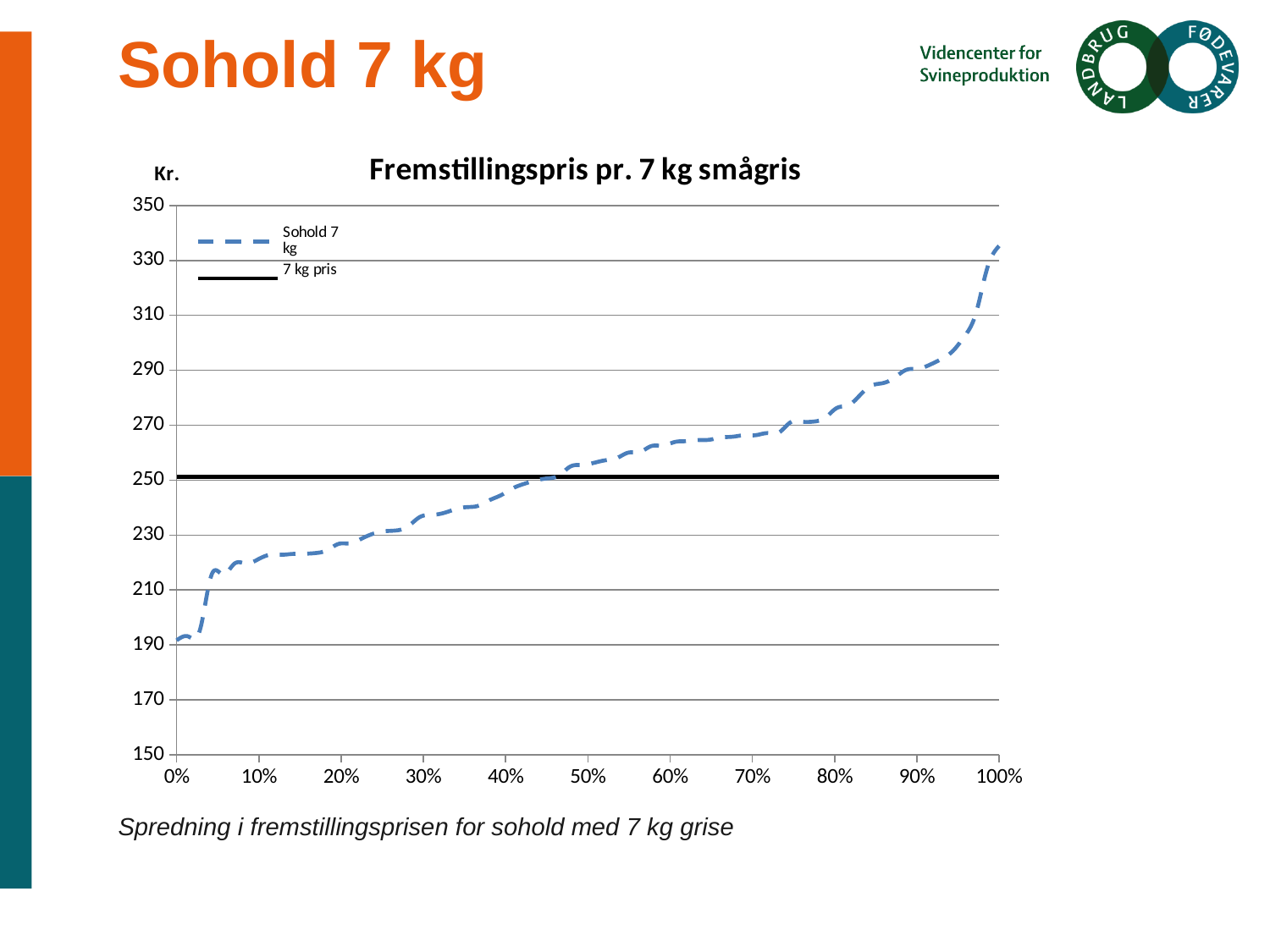
What is the title of the chart? Fremstillingspris pr. 7 kg smågris At 100%, which is higher: the Sohold 7 kg line or the 7 kg pris line? Sohold 7 kg How many series does the legend list? 2 Is the value of Sohold 7 kg at 20% greater or less than 250? less Is the value of Sohold 7 kg at 0% greater or less than 210? less Does the Sohold 7 kg line rise or fall as the x axis goes from 0% to 100%? rise Is the 7 kg pris line above or below 270? below At 0%, which is higher: the Sohold 7 kg line or the 7 kg pris line? 7 kg pris Which series is drawn as a dashed blue line? Sohold 7 kg What kind of chart is shown on the slide? line chart